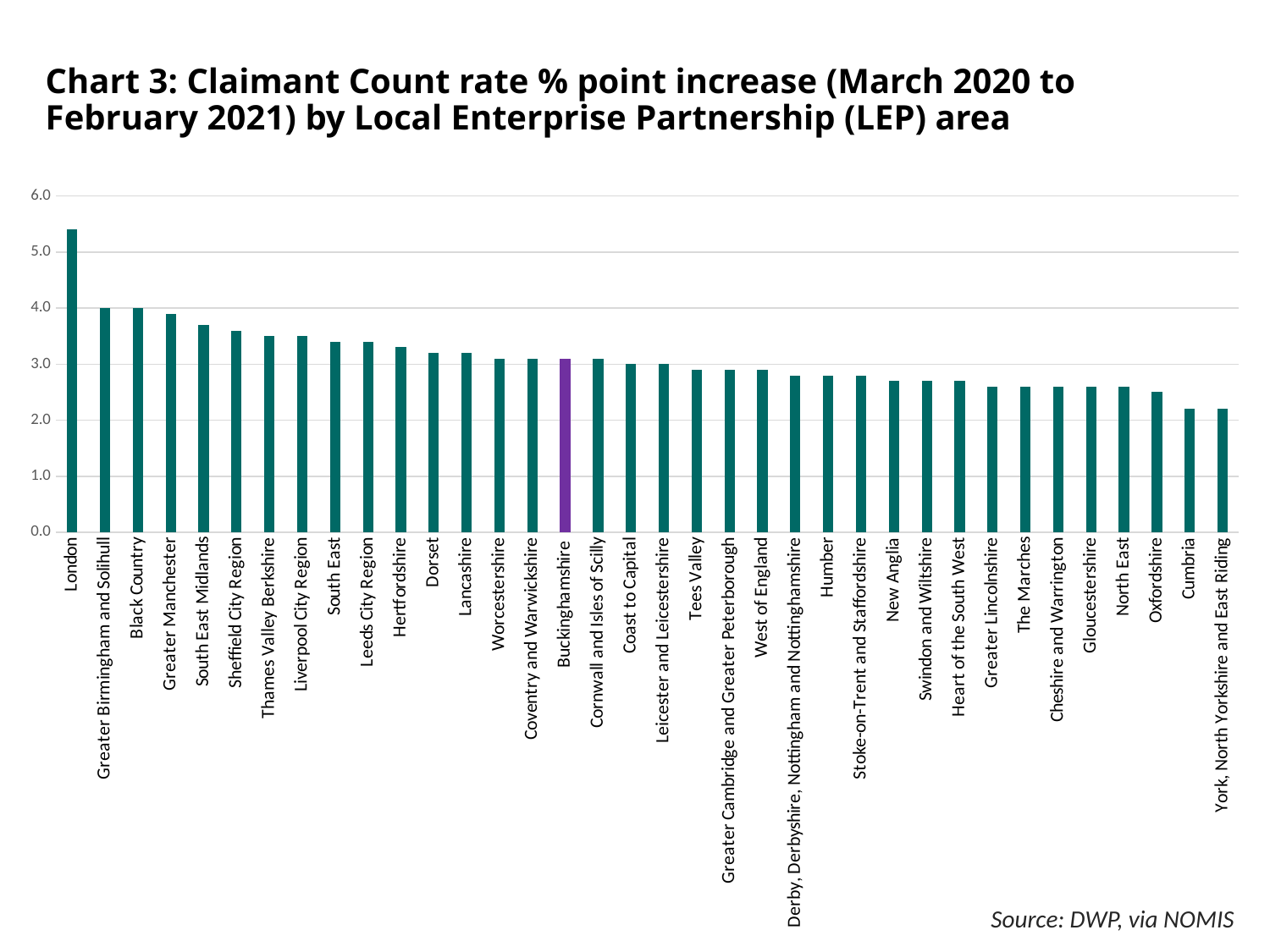
Is the value for Greater Manchester greater or less than 3.0? greater Is the value for London greater or less than 5.0? greater Do the values rise or fall moving from left to right along the x axis? fall Which has the larger value, Sheffield City Region or Cumbria? Sheffield City Region Which LEP area has the highest Claimant Count rate percentage point increase? London How many LEP areas are shown on the chart? 36 Which LEP area's bar is highlighted in purple rather than green? Buckinghamshire Is the value for Oxfordshire greater or less than 2.0? greater What kind of chart is shown on the slide? bar chart Which has the larger value, London or Greater Manchester? London